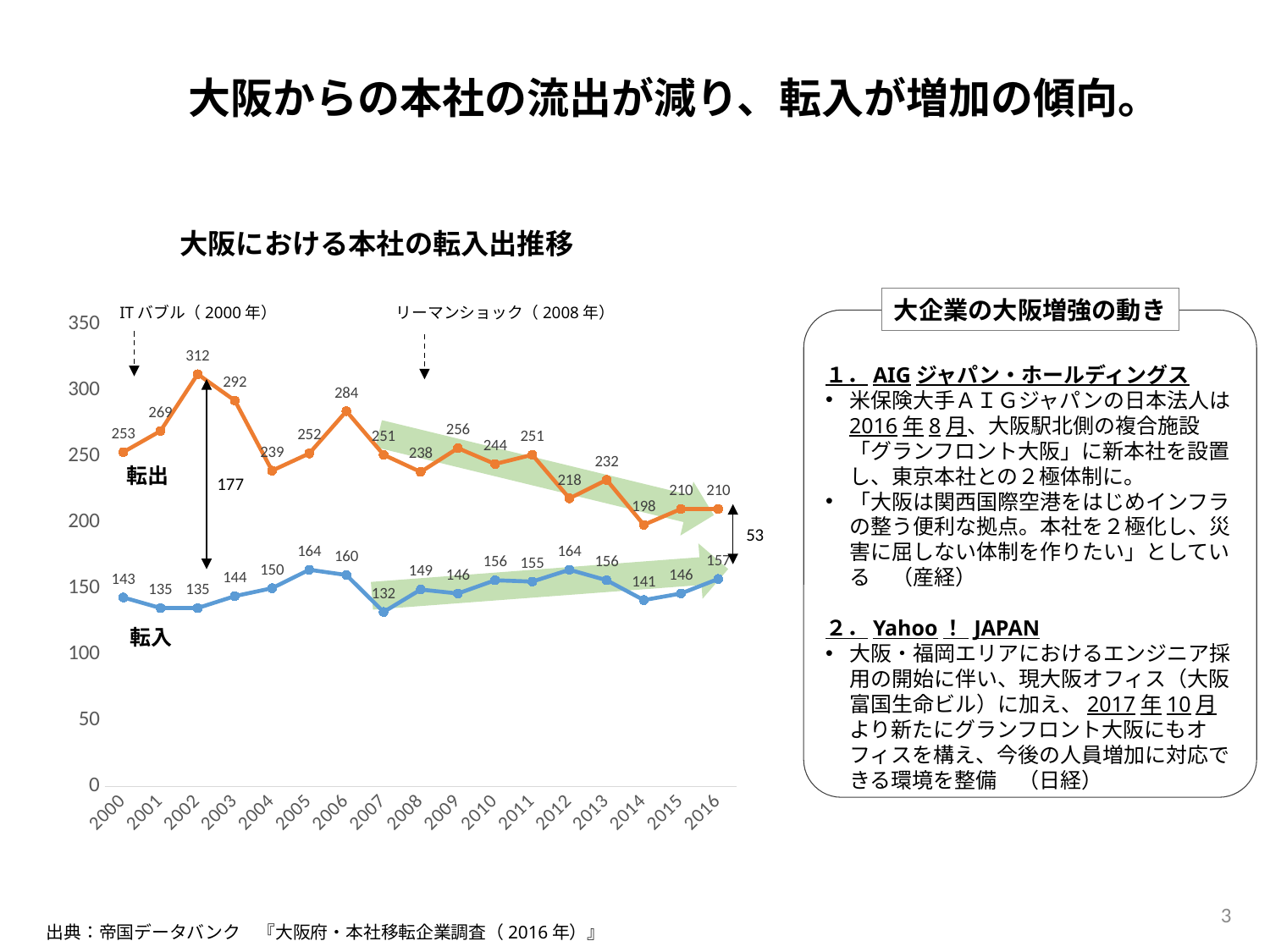
In which year is the 転入 series at its lowest? 2007 How many years are shown on the x axis of the chart? 17 How many series are plotted in the chart? 2 What kind of chart is shown on the slide? line chart Which is larger in 2008, the 転出 value or the 転入 value? 転出 In which year is the 転出 series at its highest? 2002 Does the 転出 series generally rise or fall from 2009 to 2016? fall What is the 転出 value for 2002? 312 What is the difference between 転出 and 転入 in 2016? 53 What is the difference between 転出 and 転入 in 2002? 177 What is the 転出 value for 2014? 198 What is the 転入 value for 2007? 132